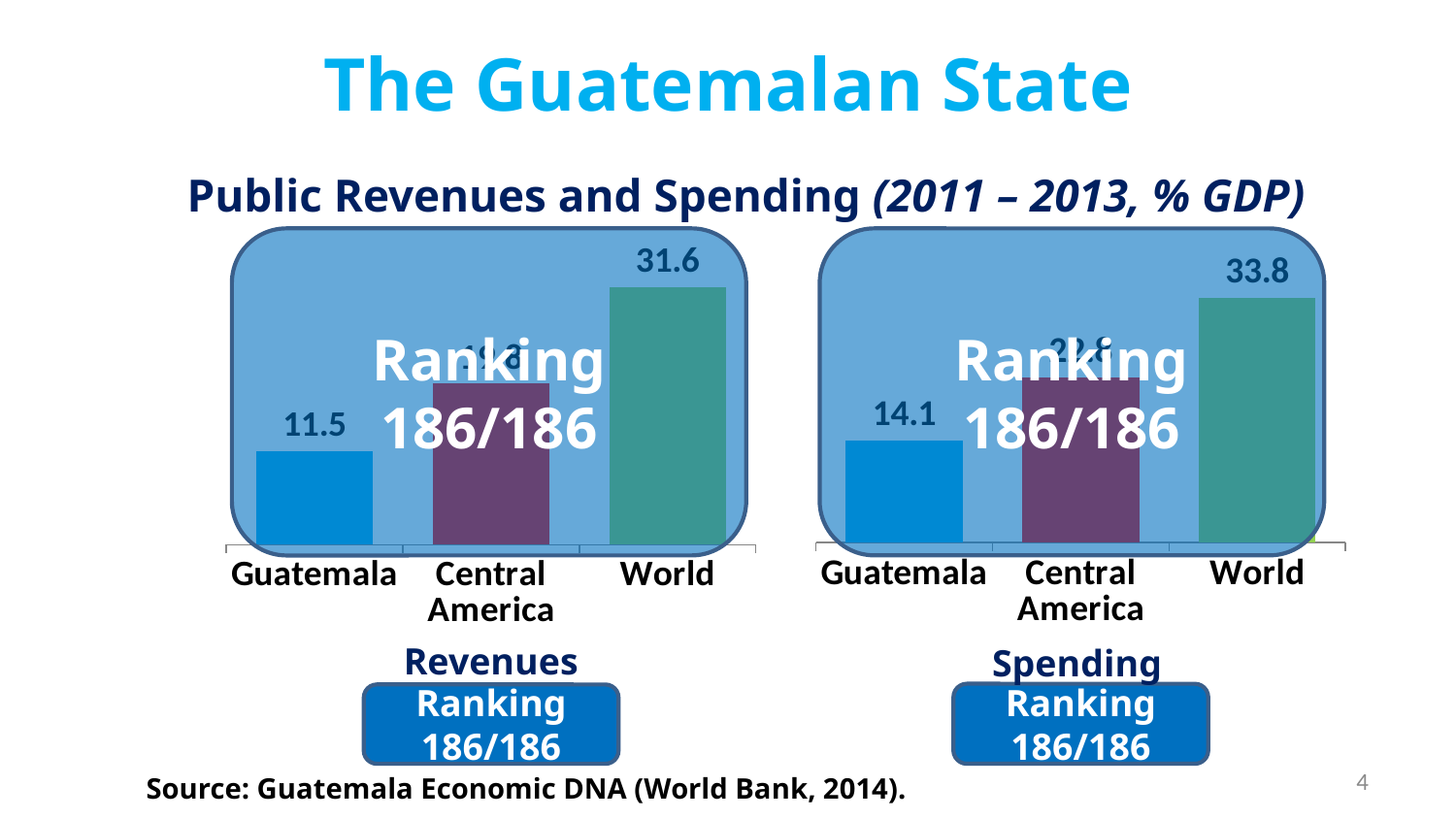
What kind of chart is the Revenues chart? Bar chart In the Spending chart, what is the difference between the World value and the Guatemala value? 19.7 In the Revenues chart, what is the value for Guatemala? 11.5 In the Revenues chart, do the values rise or fall from Guatemala to World? Rise In the Revenues chart, which category has the highest value? World In the Revenues chart, what is the difference between the World value and the Guatemala value? 20.1 Is Guatemala's value larger in the Revenues chart or in the Spending chart? Spending In the Spending chart, what is the value for World? 33.8 How many categories are shown in the Spending chart? 3 In the Revenues chart, what is the value for World? 31.6 In the Spending chart, which category has the lowest value? Guatemala In the Spending chart, what is the value for Guatemala? 14.1